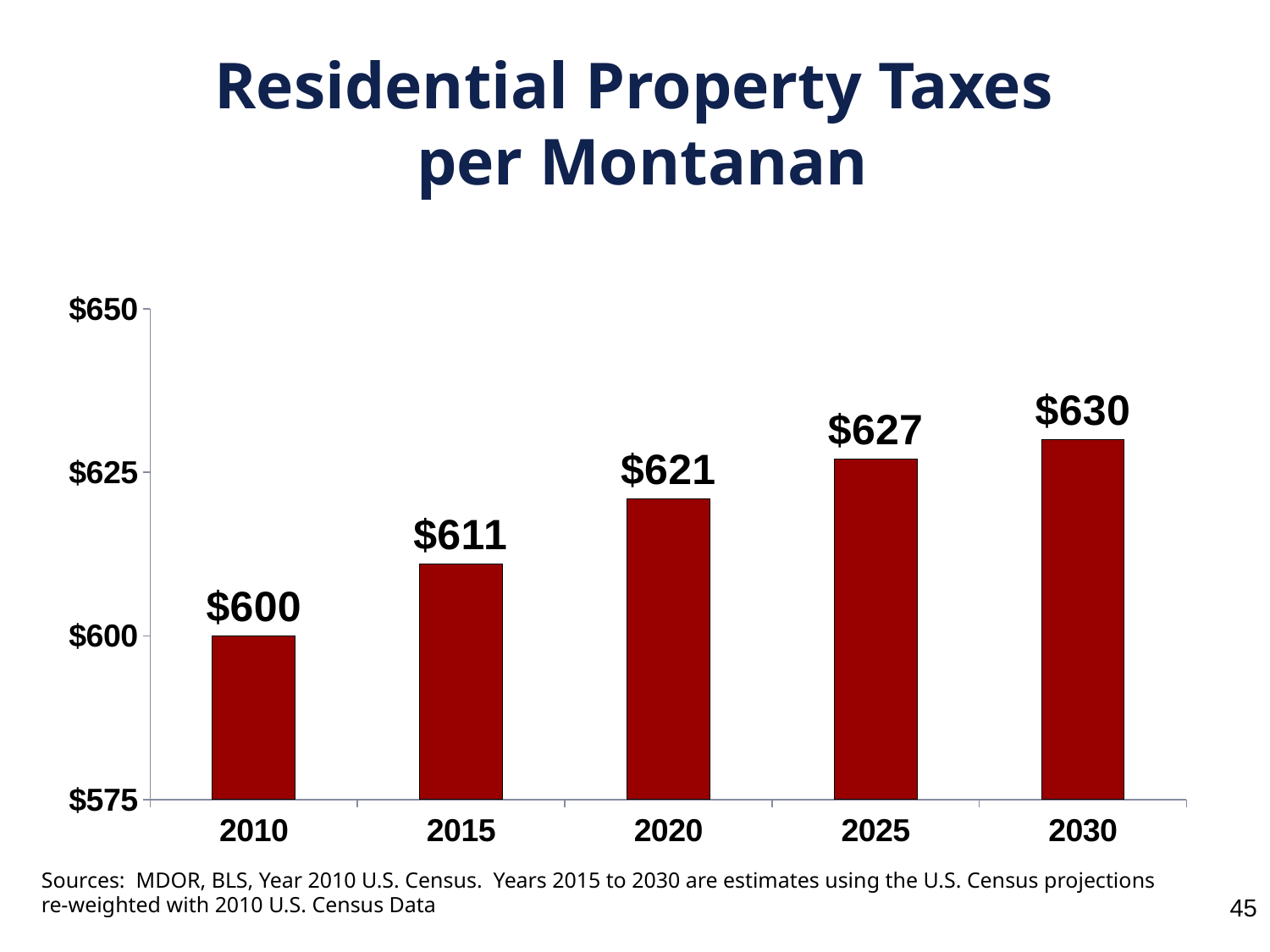
Is the value for 2020 greater or less than $625? less Which is larger, the value for 2015 or the value for 2025? 2025 Which year has the lowest residential property tax per Montanan? 2010 What is the difference between the values for 2025 and 2015? $16 What is the difference between the values for 2030 and 2010? $30 What value is shown for 2030? $630 What value is shown for 2020? $621 Which year has the highest residential property tax per Montanan? 2030 What is the residential property tax per Montanan shown for 2010? $600 What kind of chart is shown on the slide? bar chart Do the values rise or fall from 2010 to 2030? rise How many years are shown on the x axis? 5